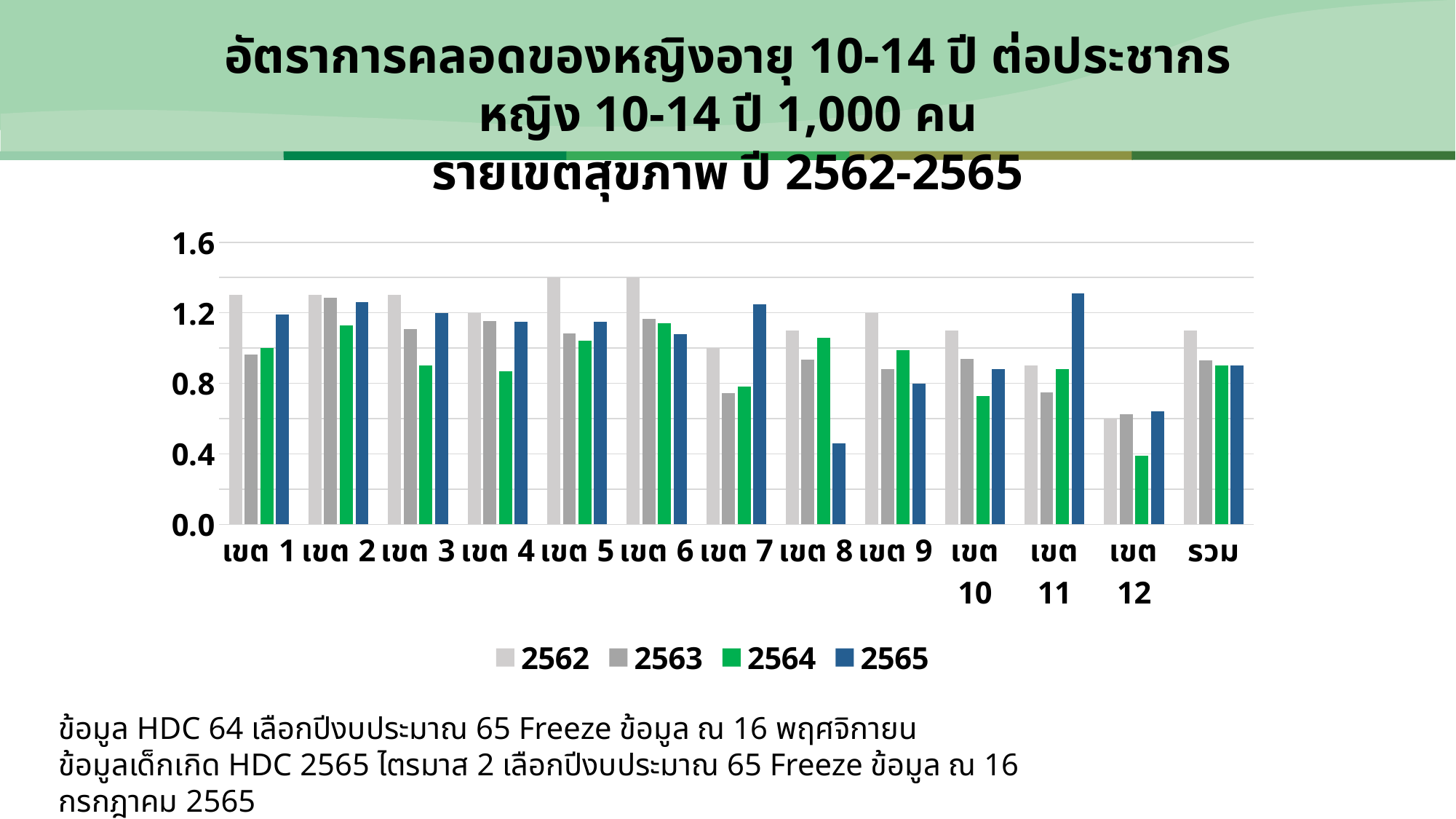
Which years are listed in the legend? 2562, 2563, 2564, 2565 Is the 2562 value for เขต 5 greater or less than 1.2? greater Which category has the lowest 2564 value? เขต 12 For เขต 8, which is larger: the 2564 value or the 2565 value? 2564 How many categories are shown along the x axis? 13 Is the 2565 value for เขต 11 greater or less than 1.2? greater What kind of chart is shown on the slide? bar chart How many series does the legend list? 4 Is the 2564 value for เขต 12 greater or less than 0.8? less Which category has the lowest 2565 value? เขต 8